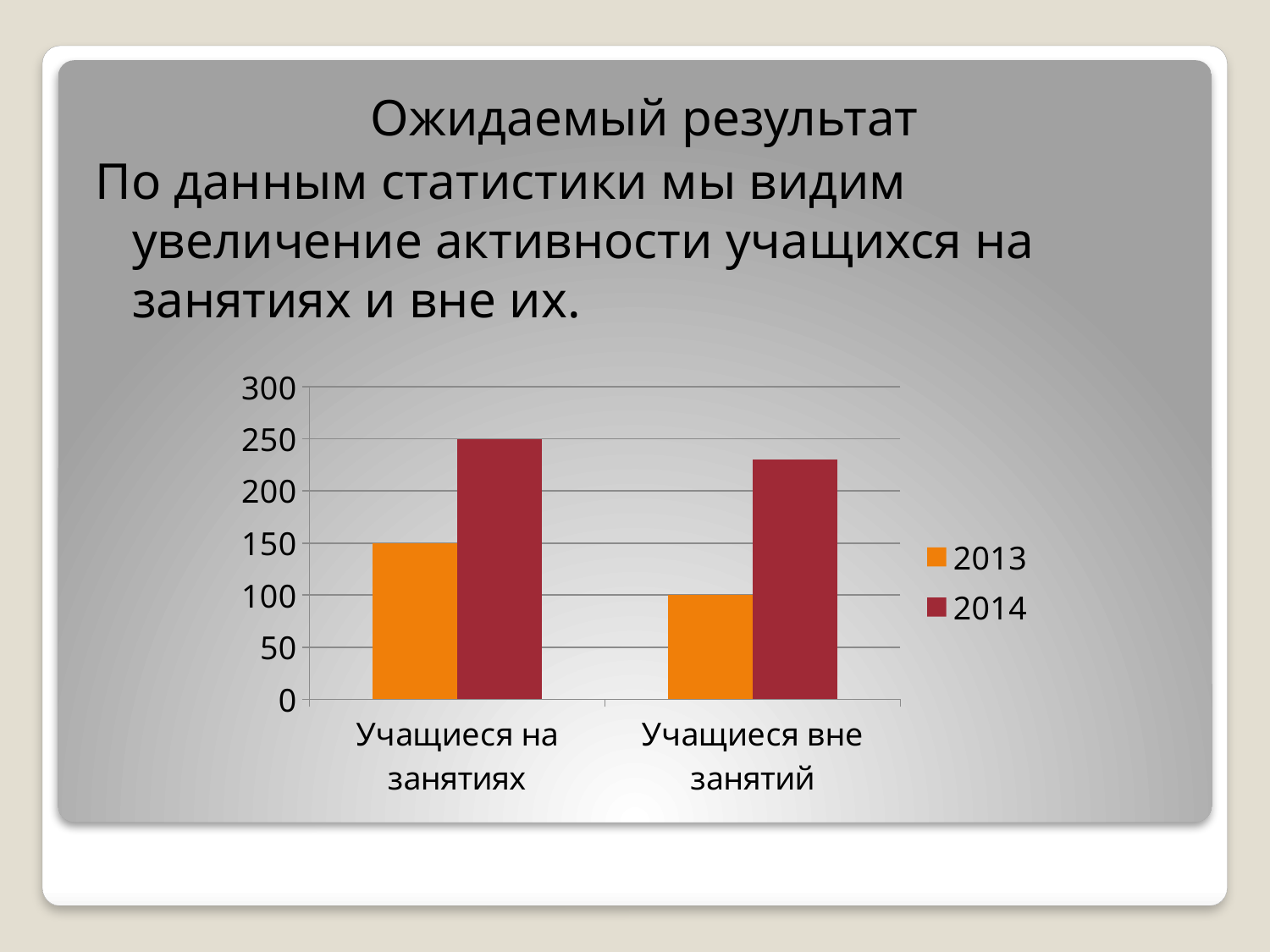
Which series has the higher value in the category "Учащиеся вне занятий", 2013 or 2014? 2014 What is the difference between the 2014 and 2013 values for "Учащиеся на занятиях"? 100 How many series does the legend list? 2 What kind of chart is shown on the slide? bar chart How many categories are shown on the x axis? 2 Which category has the lowest value for the 2013 series? Учащиеся вне занятий Is the value for 2014 in the category "Учащиеся вне занятий" greater or less than 250? less What is the value for 2013 in the category "Учащиеся вне занятий"? 100 What colour are the bars for the 2013 series? orange What is the value for 2013 in the category "Учащиеся на занятиях"? 150 Is the value for 2014 in the category "Учащиеся вне занятий" greater or less than 200? greater What is the value for 2014 in the category "Учащиеся на занятиях"? 250